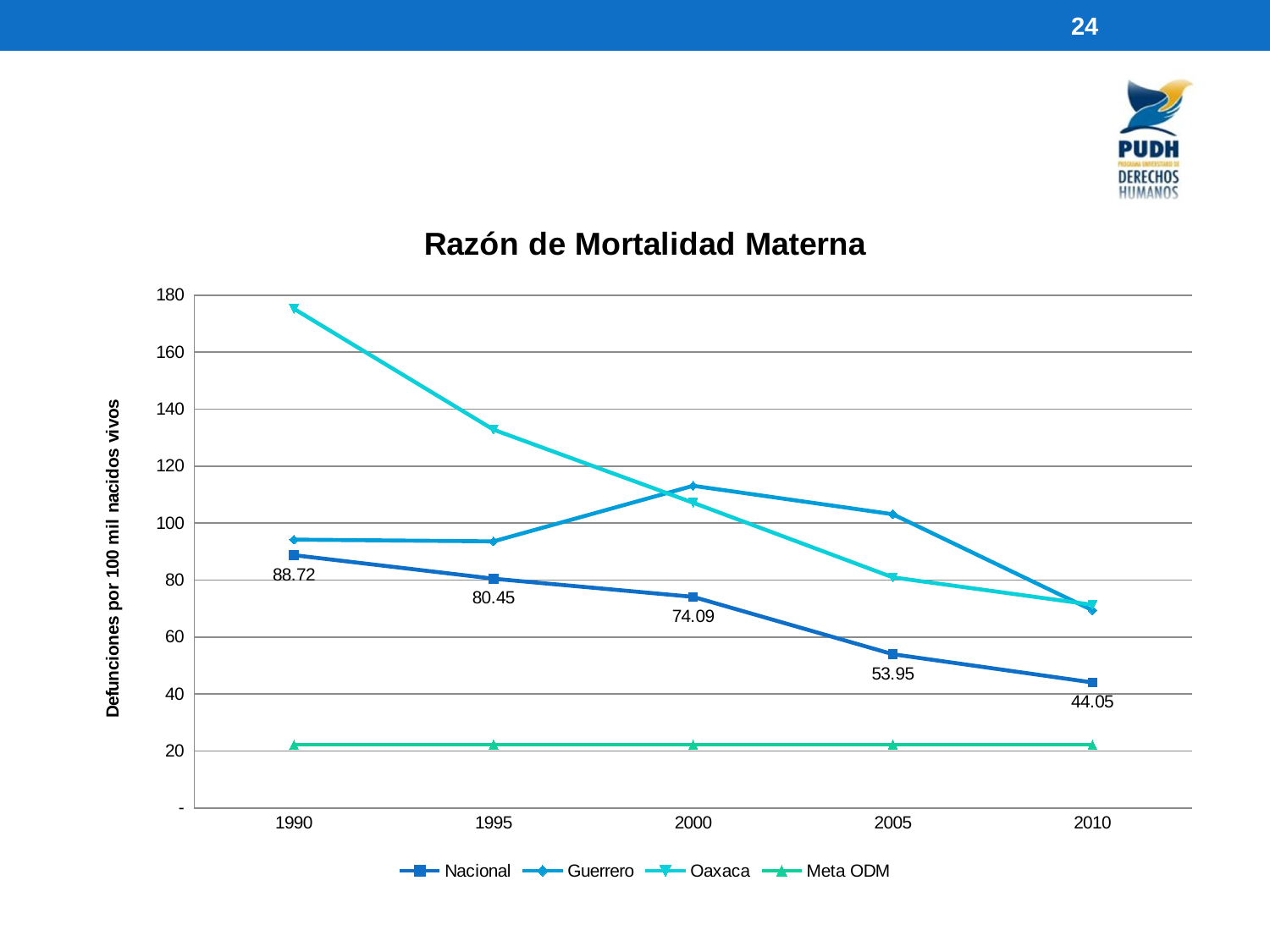
How many series does the legend list? 4 Is the value for Guerrero in 2005 greater or less than 100? greater What kind of chart is this? line chart What is the value for Nacional in 1990? 88.72 What is the value for Nacional in 2000? 74.09 Is the value for Oaxaca in 1990 greater or less than 160? greater Which is larger, the Nacional value in 1995 or in 2005? 1995 What is the difference between the Nacional values in 1990 and 2010? 44.67 What is the value for Nacional in 2010? 44.05 How many years are shown on the x axis? 5 Does the Oaxaca series rise or fall from 1990 to 2010? fall In which year is the Nacional series lowest? 2010